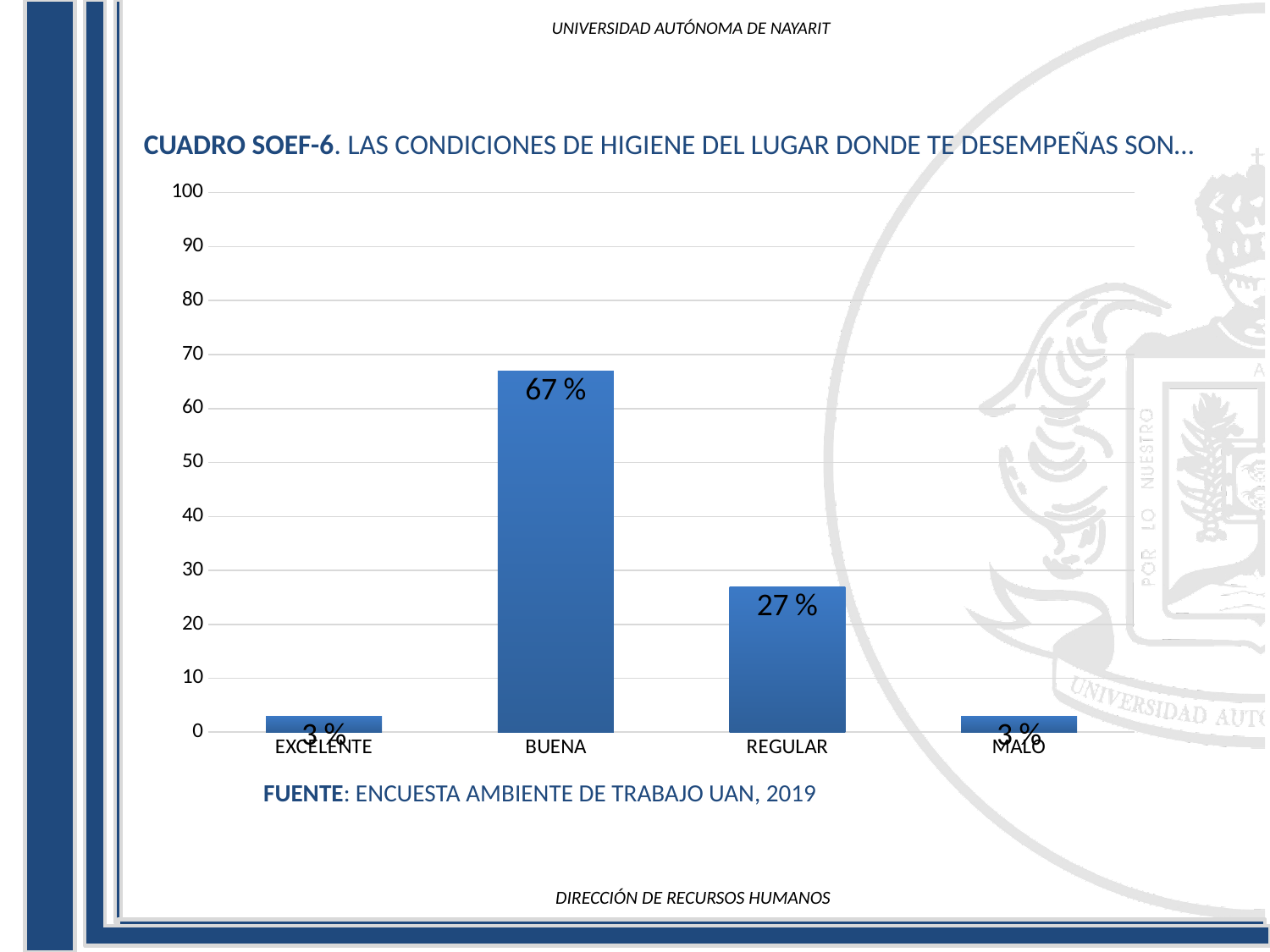
What is the value for REGULAR? 27 % What is the value for MALO? 3 % What is the value for EXCELENTE? 3 % Is the value for BUENA greater or less than 60? greater How many categories are shown on the x axis? 4 Which category has the highest value? BUENA What kind of chart is shown on the slide? bar chart Which is larger, the value for REGULAR or the value for EXCELENTE? REGULAR What source is cited below the chart? ENCUESTA AMBIENTE DE TRABAJO UAN, 2019 What is the difference between the values for BUENA and REGULAR? 40 % What is the value for BUENA? 67 % Is the value for REGULAR greater or less than 30? less